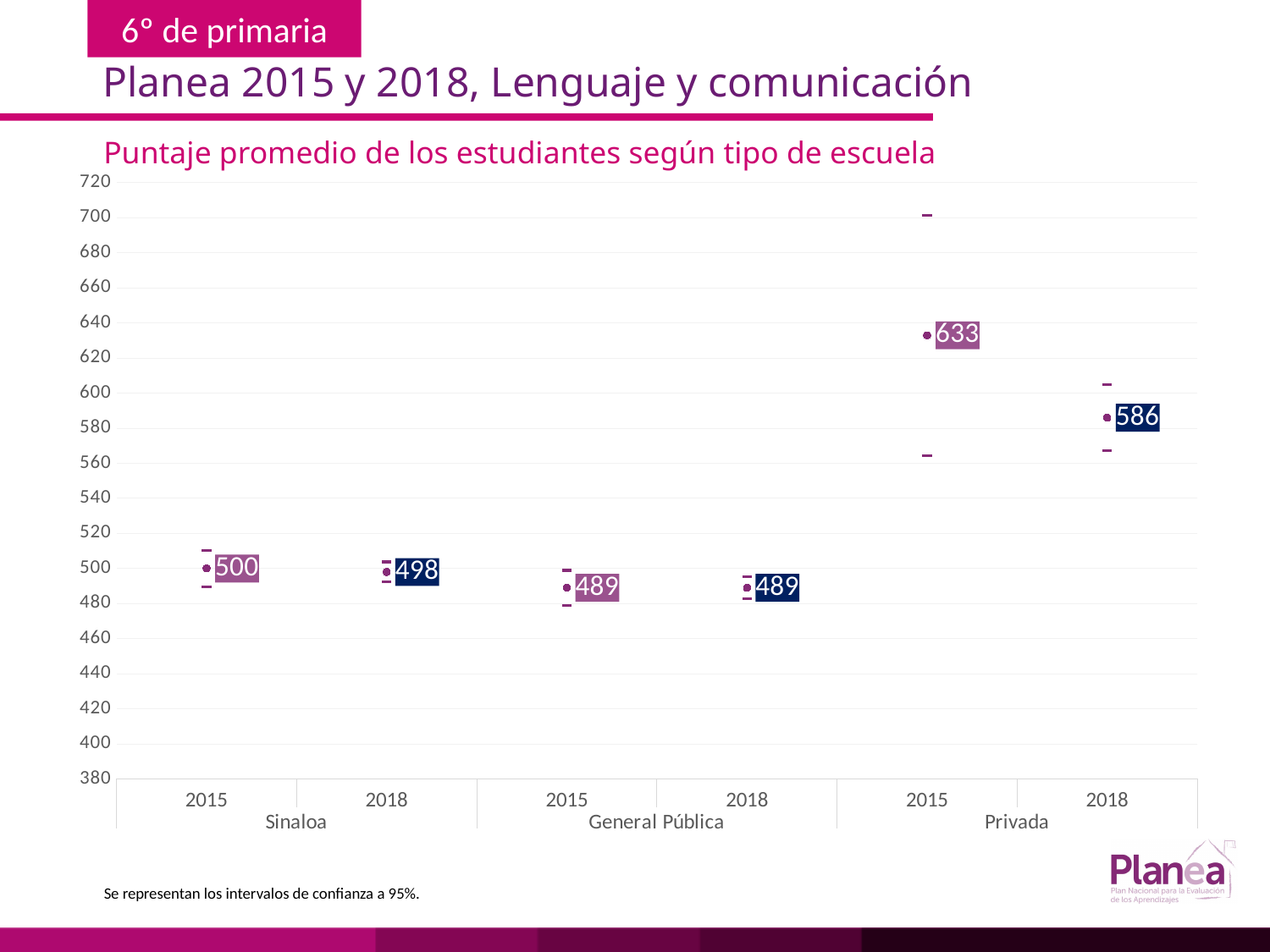
What is the average score for Sinaloa in 2015? 500 Which school type and year has the highest average score? Privada 2015 What is the average score for Sinaloa in 2018? 498 Did the Privada average score rise or fall from 2015 to 2018? fall What is the average score for Privada in 2018? 586 What is the title of the chart? Puntaje promedio de los estudiantes según tipo de escuela Which is larger, the Sinaloa score in 2018 or the General Pública score in 2018? Sinaloa 2018 What is the average score for General Pública in 2015? 489 What is the difference between the Privada scores in 2015 and 2018? 47 What is the average score for Privada in 2015? 633 What is the difference between the Sinaloa score in 2015 and the General Pública score in 2015? 11 How many data points are plotted on the chart? 6